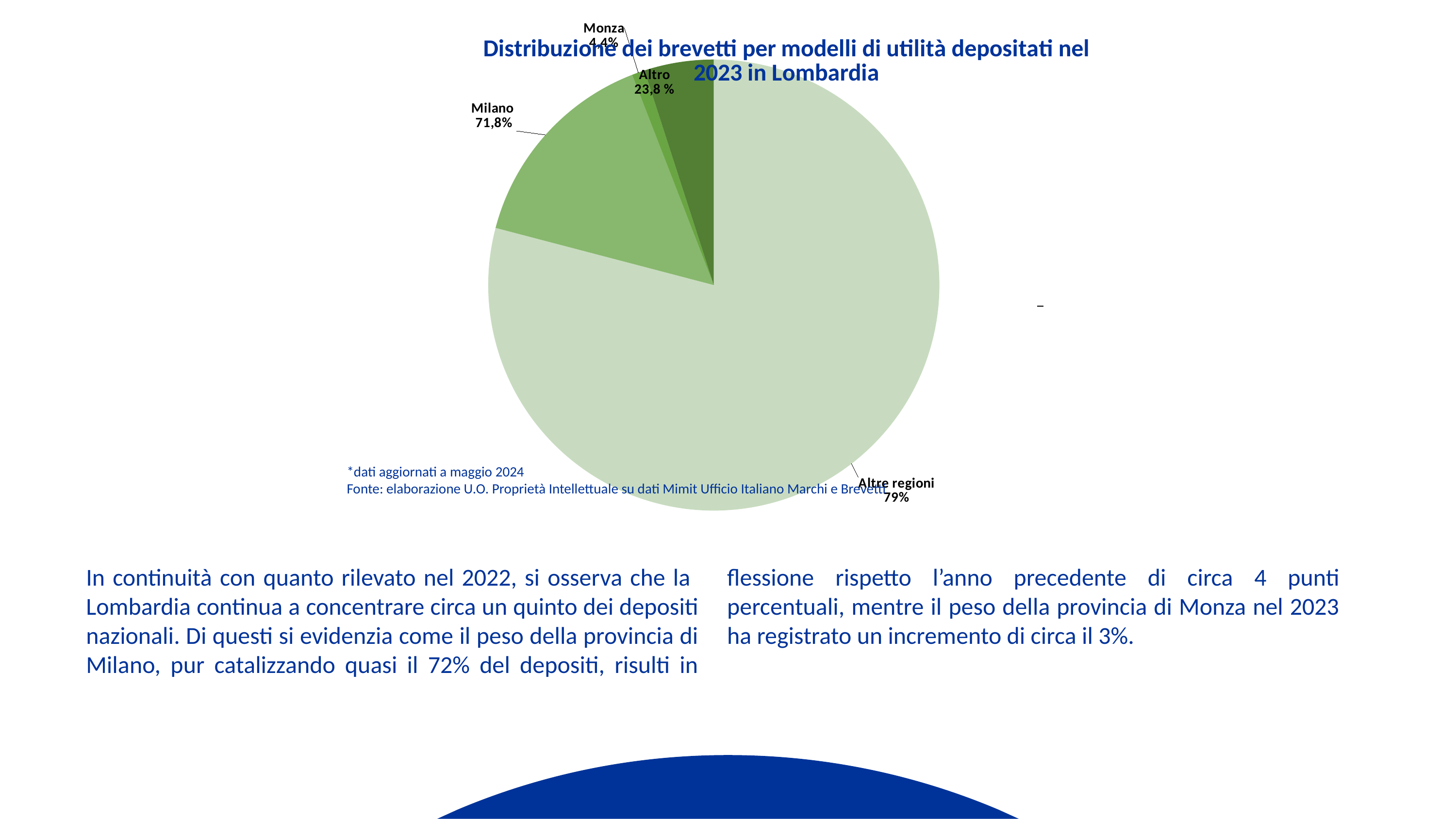
What is the difference in percentage points between the labels for Altro and Monza? 19,4 What kind of chart is shown on the slide? pie chart What is the title of the chart? Distribuzione dei brevetti per modelli di utilità depositati nel 2023 in Lombardia What is the difference in percentage points between the labels for Milano and Monza? 67,4 Which slice of the pie is the largest? Altre regioni What percentage is shown for Altro? 23,8 % How many slices does the pie chart have? 4 Which is larger, the slice for Milano or the slice for Altro? Milano What percentage is shown for Milano? 71,8% What percentage is shown for Altre regioni? 79% Which slice of the pie is the smallest? Monza What percentage is shown for Monza? 4,4%